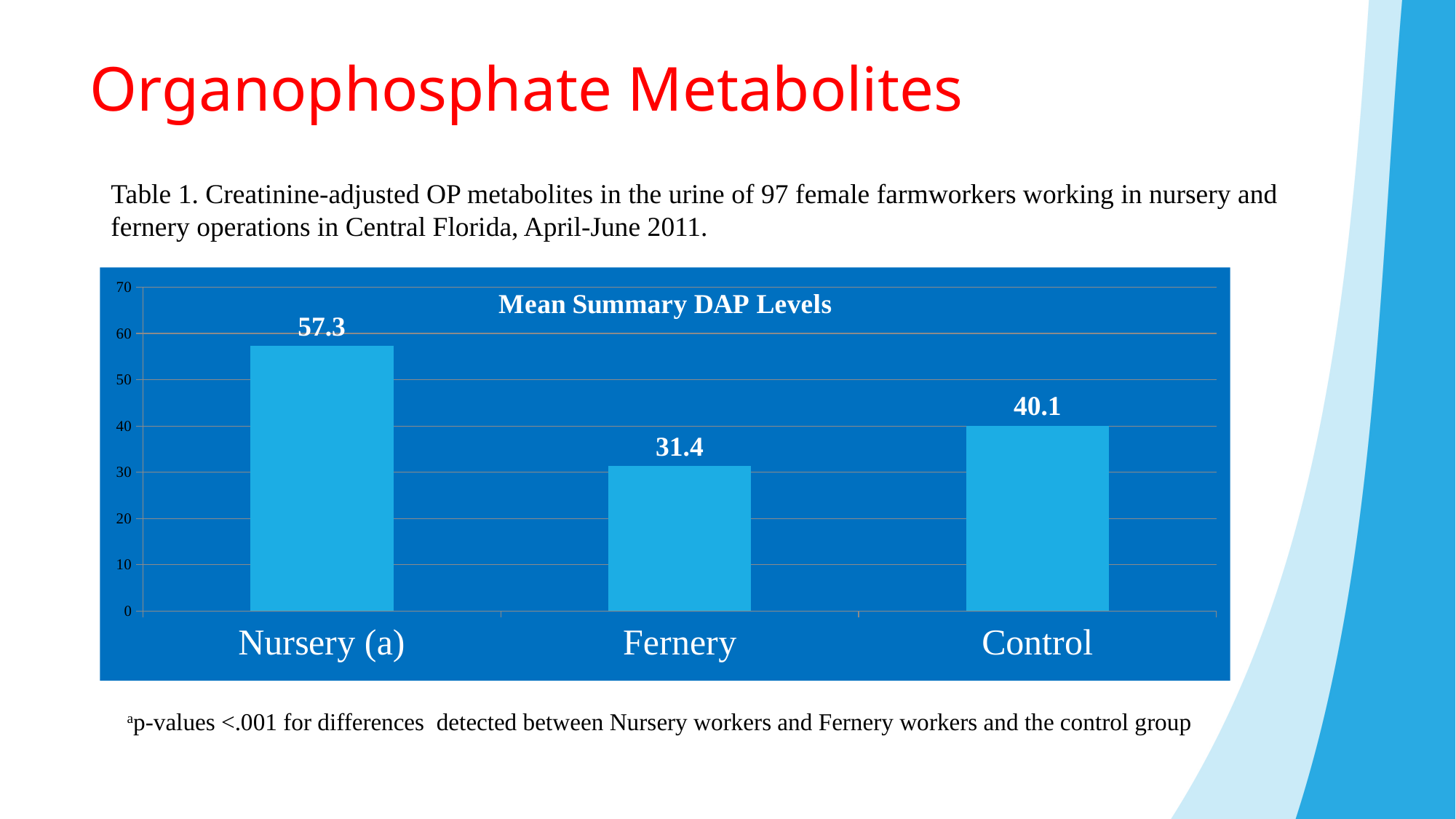
Is the value for Nursery (a) greater or less than 50? greater Which category has the highest Mean Summary DAP Level? Nursery (a) What kind of chart is shown on the slide? Bar chart What is the difference between the Nursery (a) and Fernery values? 25.9 What is the title of the chart? Mean Summary DAP Levels How many categories are shown on the chart? 3 Which category has the lowest Mean Summary DAP Level? Fernery What is the difference between the Control and Fernery values? 8.7 Which is larger, the value for Control or the value for Fernery? Control What is the Mean Summary DAP Level for Fernery? 31.4 What is the Mean Summary DAP Level for Control? 40.1 What is the Mean Summary DAP Level for Nursery (a)? 57.3